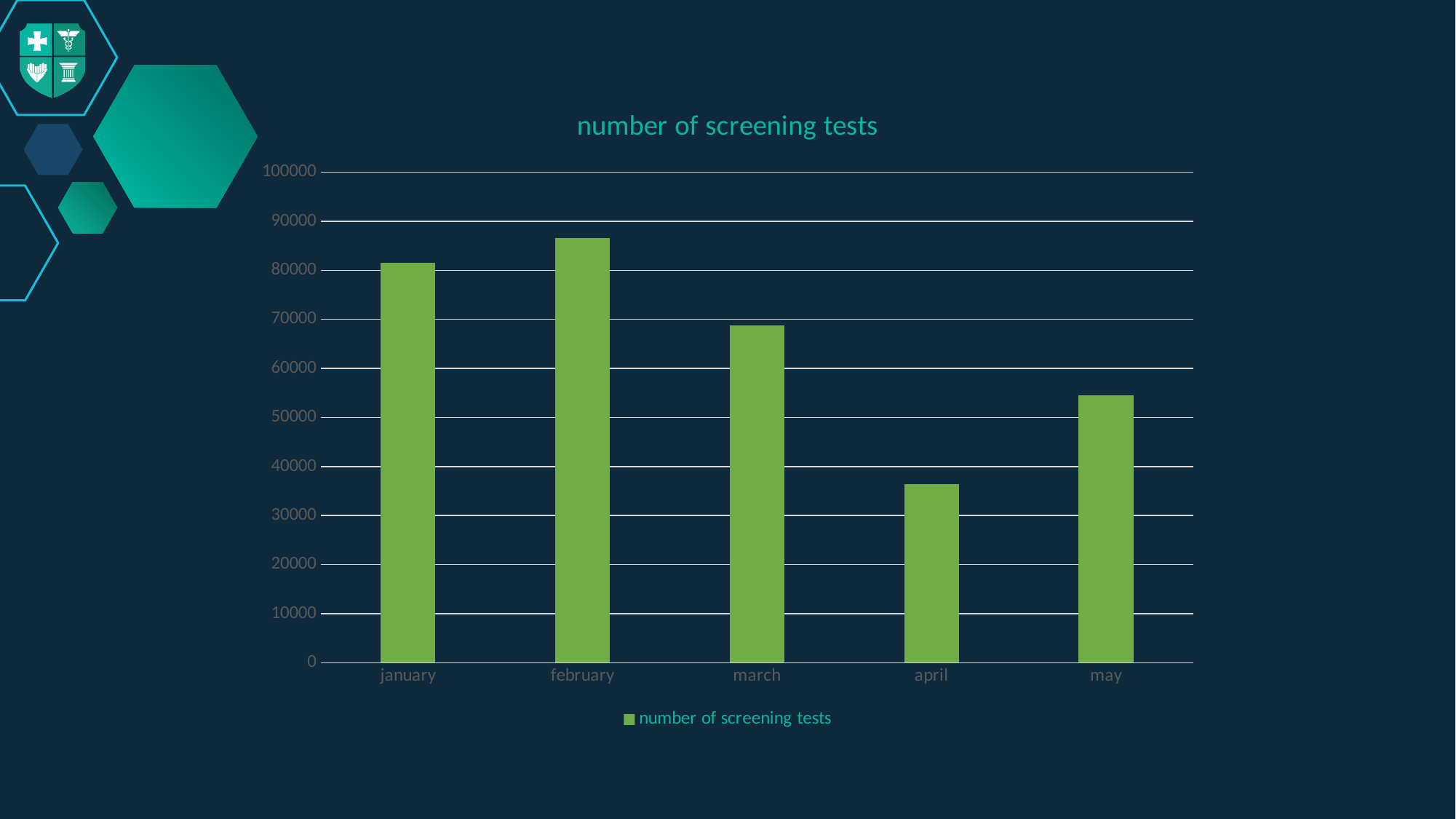
What is the title of the chart? number of screening tests Which month has more screening tests, march or may? march Is the value for may greater or less than 50000? greater How many series does the legend list? 1 Is the value for april greater or less than 40000? less Which month has the highest number of screening tests? february Do the values rise or fall from february to april? fall Is the value for march greater or less than 70000? less Which month has the lowest number of screening tests? april How many months are shown on the x axis of the chart? 5 What type of chart is shown on the slide? bar chart